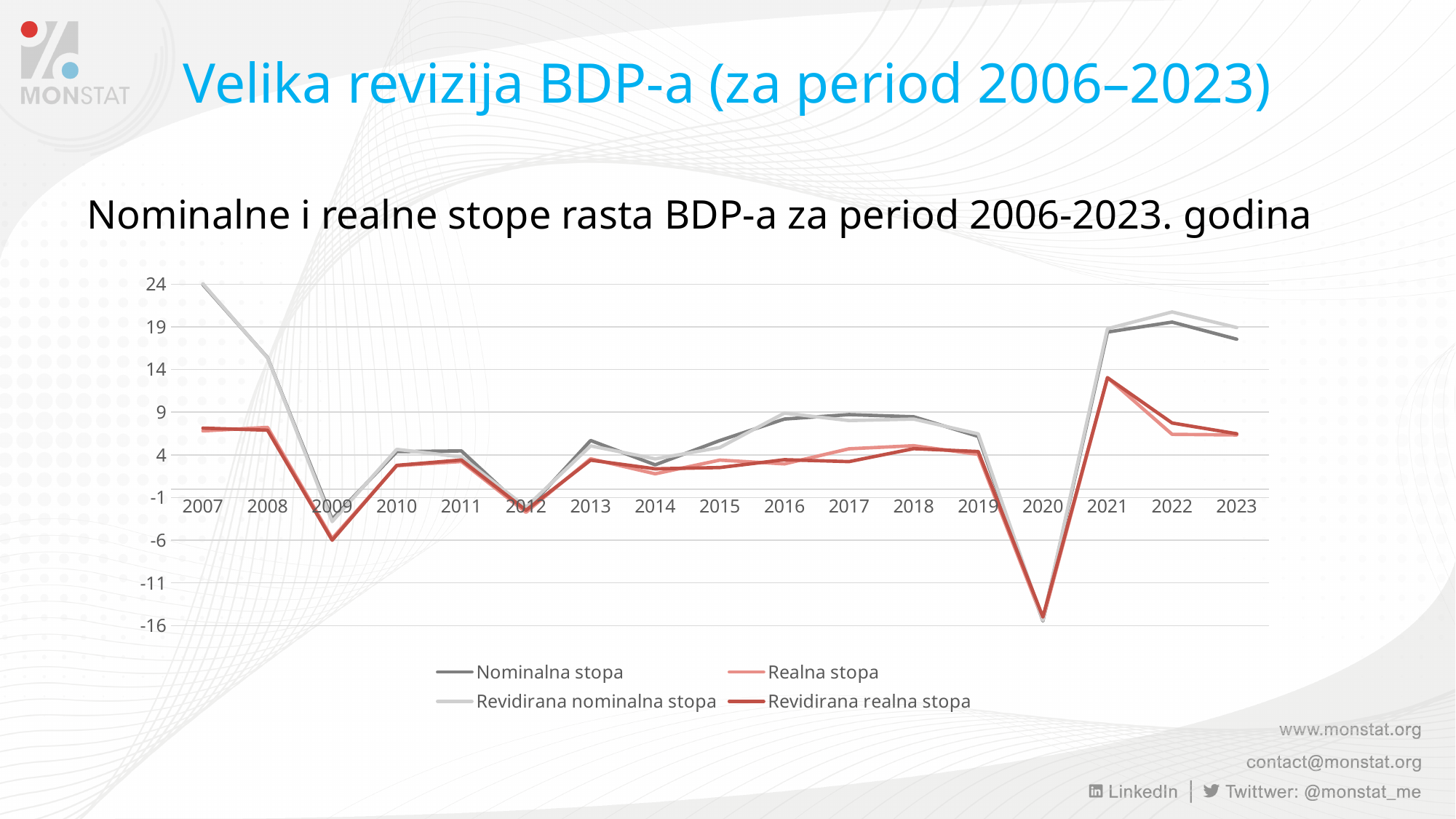
In 2007, which is larger: Nominalna stopa or Revidirana realna stopa? Nominalna stopa Is the value for Revidirana nominalna stopa in 2021 greater or less than 14? greater Is the value for Revidirana realna stopa in 2009 greater or less than -1? less How many years are plotted along the x axis? 17 In which year does the Revidirana realna stopa series reach its lowest value? 2020 Is the value for Nominalna stopa in 2020 greater or less than -11? less What kind of chart is shown on the slide? line chart How many series does the legend list? 4 In which year does the Nominalna stopa series reach its highest value? 2007 Which legend entry is drawn in dark red? Revidirana realna stopa Does the Nominalna stopa series rise or fall from 2007 to 2009? fall